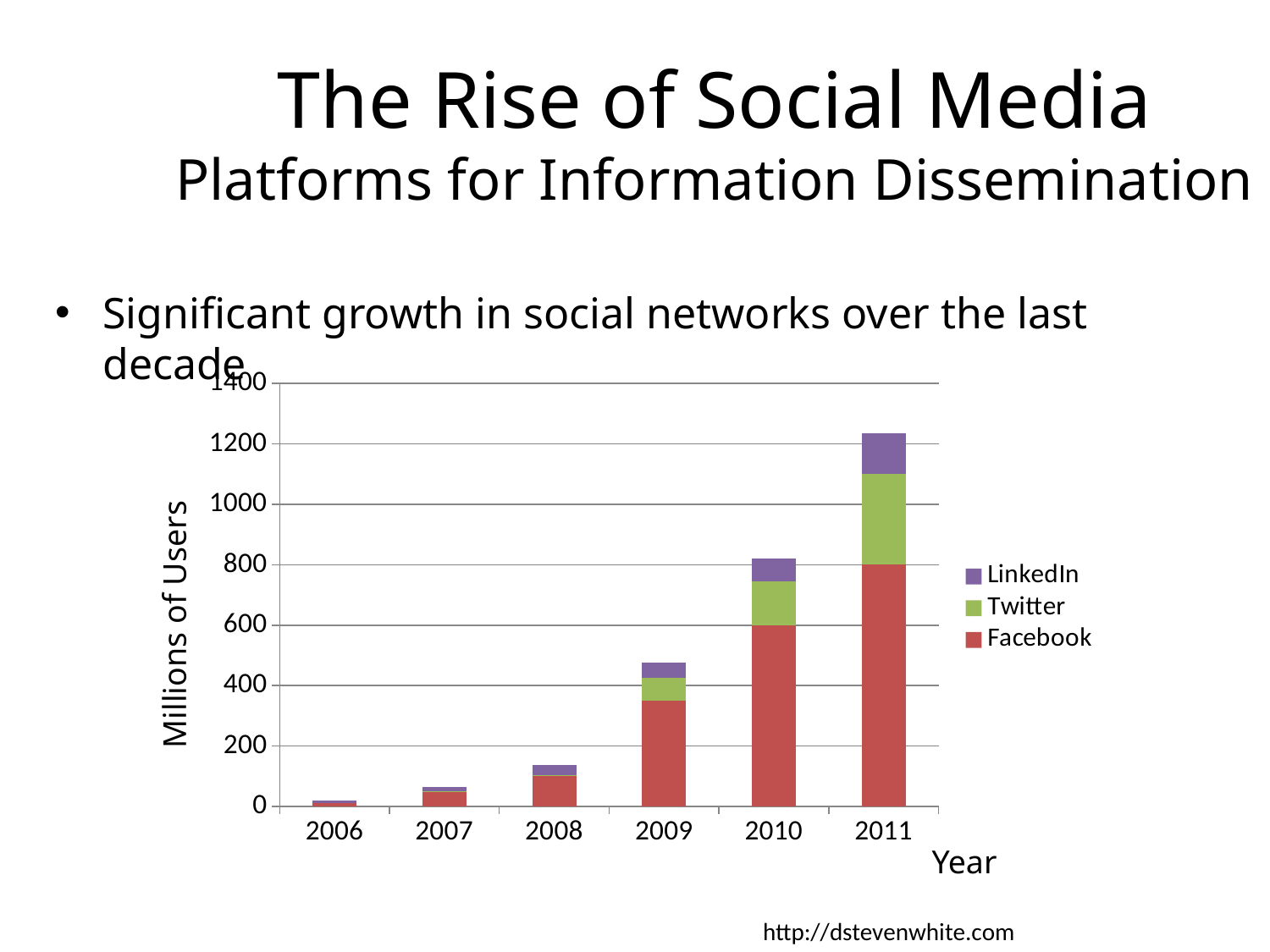
How many years are shown on the x axis of the chart? 6 Is the total stacked value for 2009 greater or less than 600? less How many series does the chart's legend list? 3 What is the label on the vertical axis of the chart? Millions of Users Which year has the lowest total stacked bar? 2006 Which year has the highest total stacked bar? 2011 Is the total stacked value for 2011 greater or less than 1000? greater Which year has the larger total stacked bar, 2009 or 2010? 2010 Do the total bar heights rise or fall from 2006 to 2011? Rise Is the total stacked value for 2008 greater or less than 200? less What kind of chart is shown on the slide? Stacked bar chart Which series is shown in purple in the chart's legend? LinkedIn